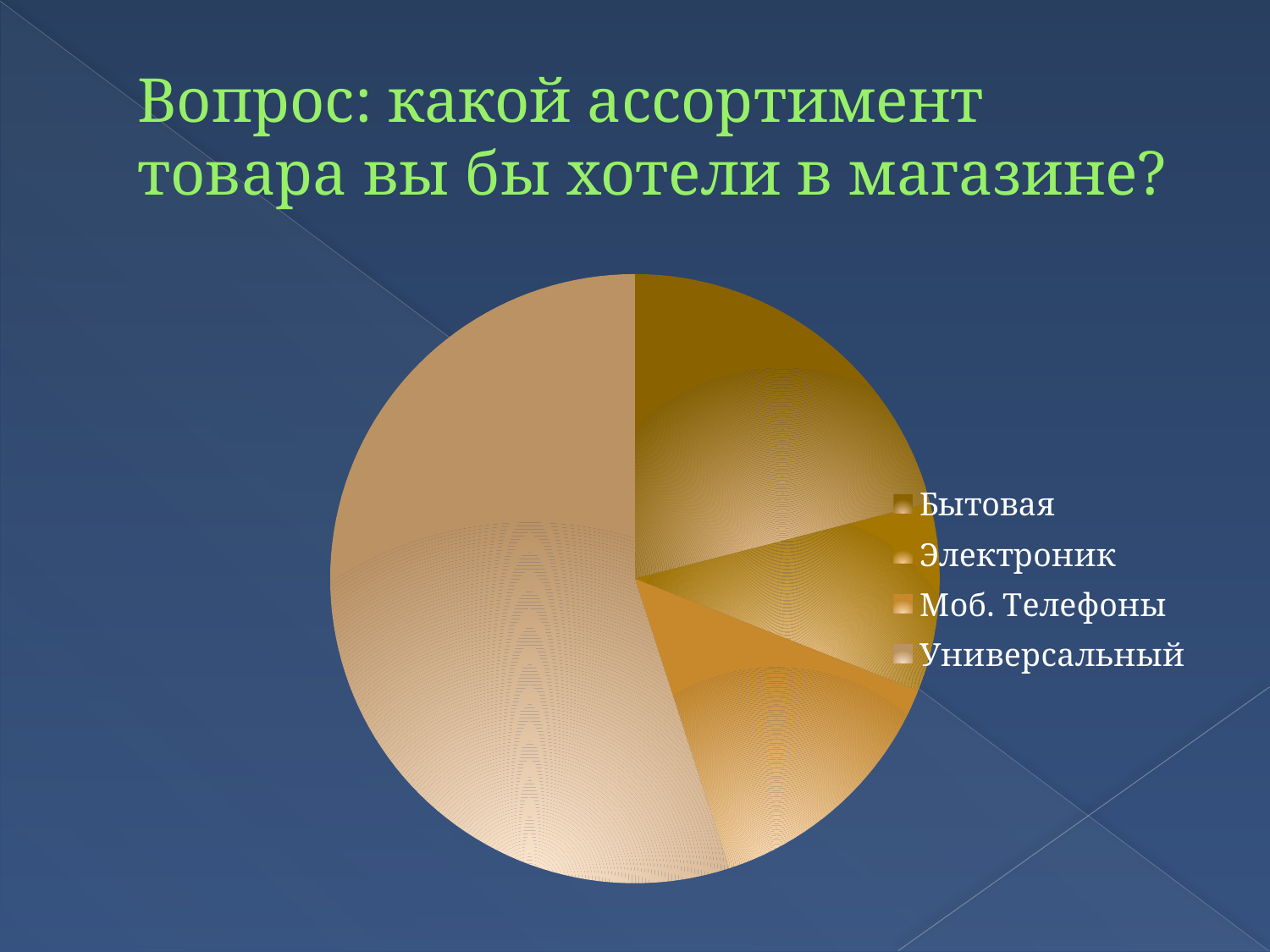
How many slices does the pie chart have? 4 Which category has the largest slice of the pie? Универсальный Which legend entry is listed first? Бытовая Which category has the smallest slice of the pie? Электроник How many entries does the legend list? 4 What kind of chart is shown on the slide? pie chart Which slice is larger, Универсальный or Бытовая? Универсальный What question is posed in the slide title above the chart? Вопрос: какой ассортимент товара вы бы хотели в магазине? Which slice is larger, Моб. Телефоны or Электроник? Моб. Телефоны Does the Универсальный slice take up more or less than half of the pie? more Which slice is larger, Бытовая or Моб. Телефоны? Бытовая